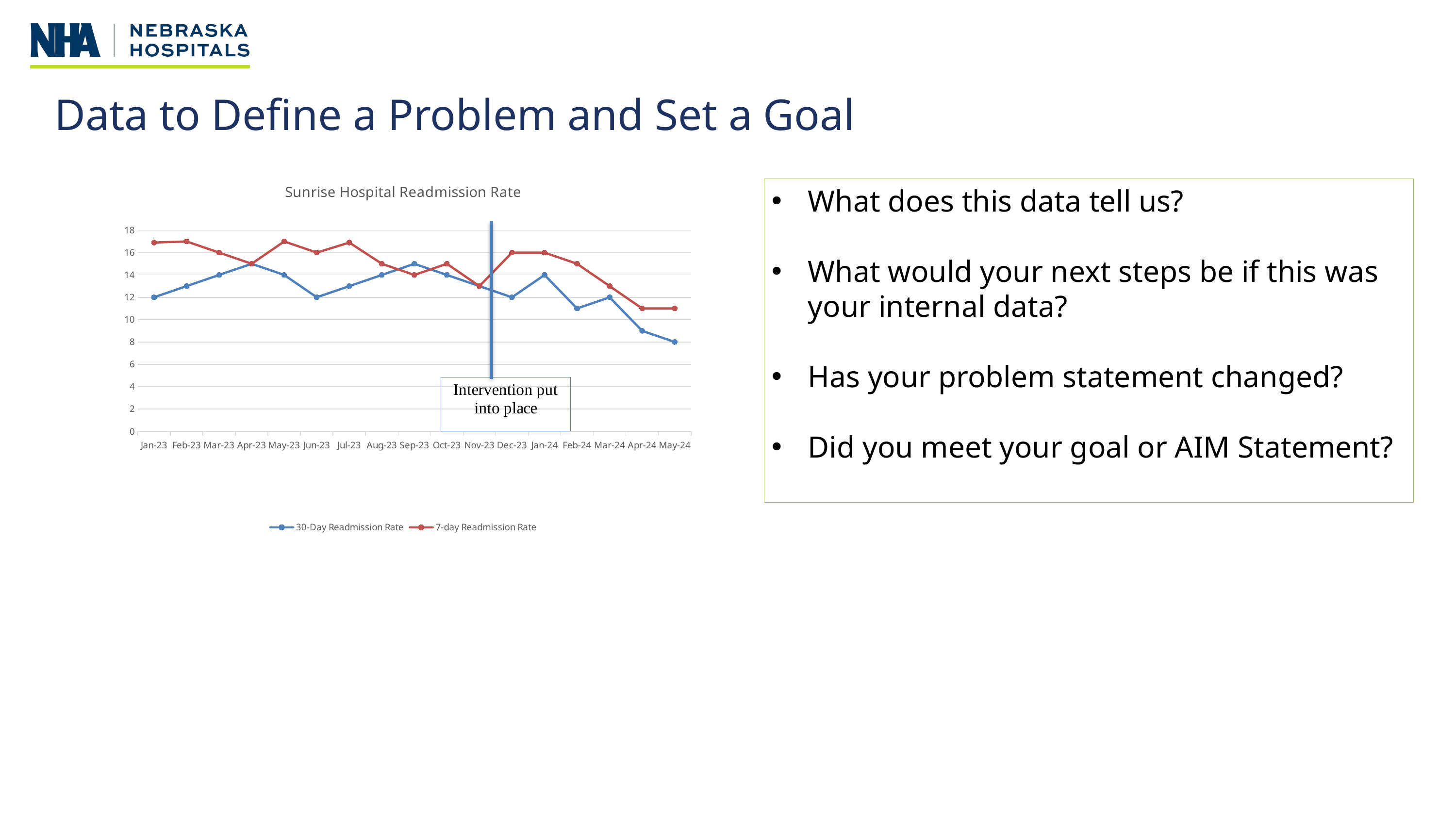
What is the difference between the 30-Day Readmission Rate in Jan-23 and in May-24? 4 What kind of chart is shown on the slide? Line chart In which month is the 30-Day Readmission Rate lowest? May-24 How many months are plotted along the x axis of the chart? 17 Which series has the higher value in Jan-23, the 30-Day Readmission Rate or the 7-day Readmission Rate? 7-day Readmission Rate What is the 30-Day Readmission Rate for Jan-23? 12 What is the title of the chart? Sunrise Hospital Readmission Rate How many series does the chart legend list? 2 What is the 30-Day Readmission Rate for May-24? 8 What is the 7-day Readmission Rate for Dec-23? 16 Is the 30-Day Readmission Rate for Apr-24 greater or less than 10? less Does the 30-Day Readmission Rate rise or fall from Jan-24 to May-24? Fall